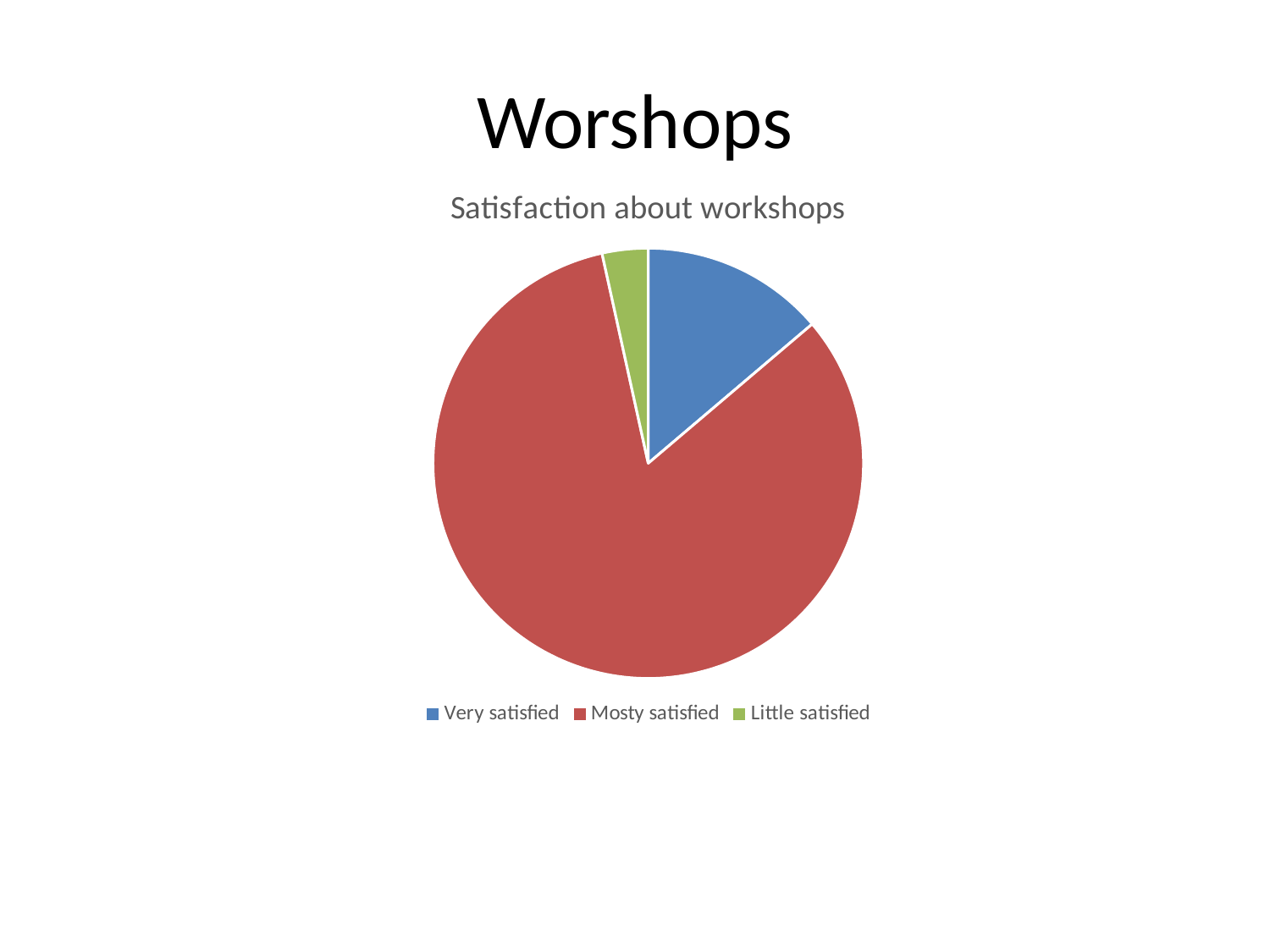
Which category has the smallest slice of the pie? Little satisfied Which slice is larger, Mosty satisfied or Very satisfied? Mosty satisfied What kind of chart is shown on the slide? pie chart Which colour represents the Little satisfied category? green Which slice is larger, Very satisfied or Little satisfied? Very satisfied Which category has the largest slice of the pie? Mosty satisfied How many slices does the pie chart have? 3 How many entries does the legend list? 3 What is the title of the chart? Satisfaction about workshops